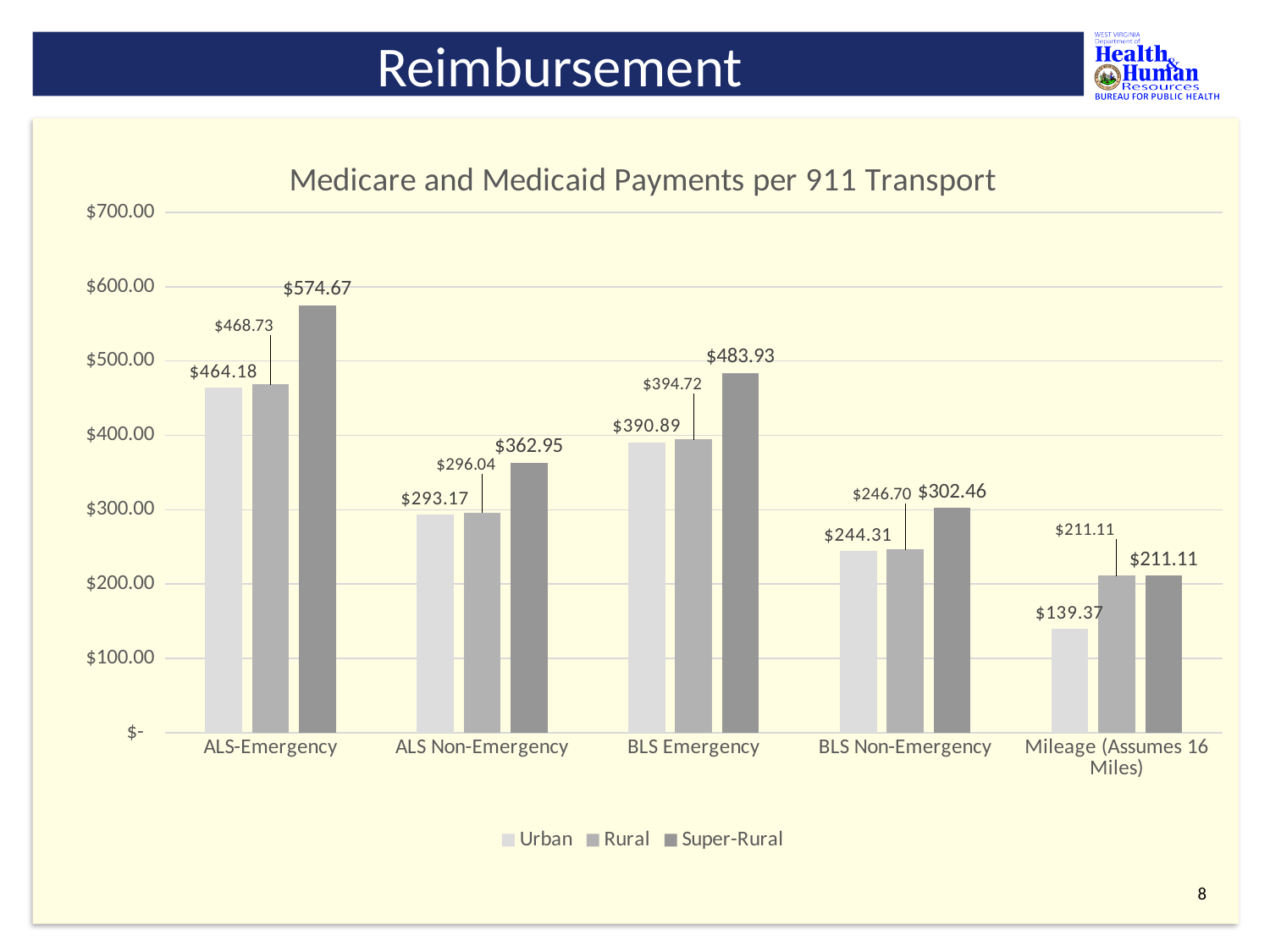
What is the Urban value for Mileage (Assumes 16 Miles)? $139.37 Is the Super-Rural value for BLS Non-Emergency greater or less than $300.00? greater What is the title of the chart? Medicare and Medicaid Payments per 911 Transport Which category has the lowest Urban value? Mileage (Assumes 16 Miles) How many categories are shown on the x axis? 5 How many series does the legend list? 3 What is the Super-Rural value for ALS-Emergency? $574.67 Which category has the highest Super-Rural value? ALS-Emergency What is the difference between the Super-Rural and Urban values for BLS Emergency? $93.04 What is the Rural value for BLS Emergency? $394.72 What kind of chart is shown on the slide? Bar chart Which is larger, the Super-Rural value for ALS Non-Emergency or the Urban value for BLS Emergency? Urban value for BLS Emergency